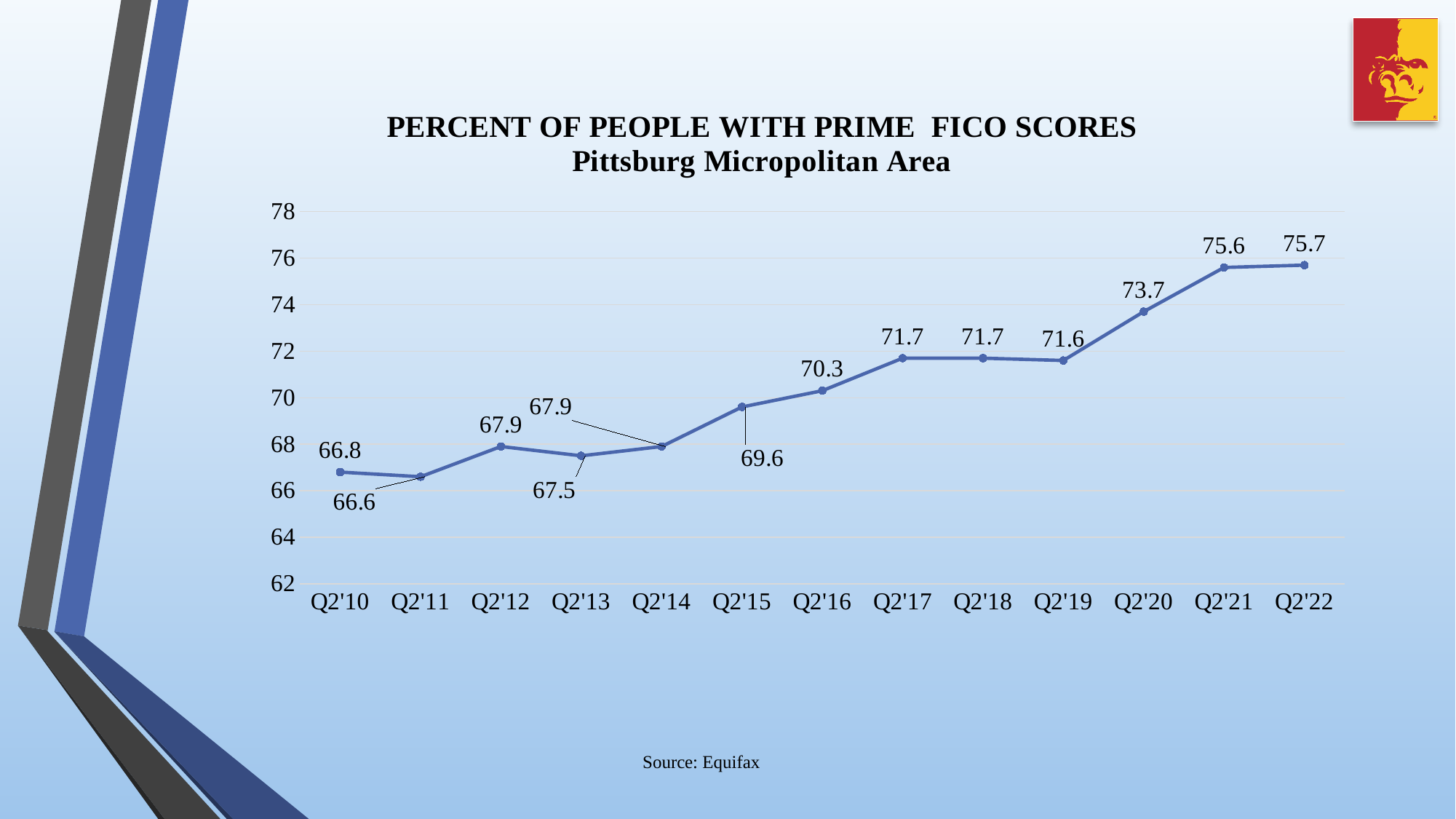
What kind of chart is shown on the slide? line chart What is the value for Q2'20? 73.7 How many data points are plotted on the chart? 13 What is the difference between the values for Q2'22 and Q2'10? 8.9 What is the value for Q2'10? 66.8 What is the difference between the values for Q2'21 and Q2'20? 1.9 Which quarter has the highest value? Q2'22 What is the source cited below the chart? Equifax Which is larger, the value for Q2'13 or the value for Q2'14? Q2'14 Is the value for Q2'16 greater or less than 70? greater What is the value for Q2'15? 69.6 Which quarter has the lowest value? Q2'11